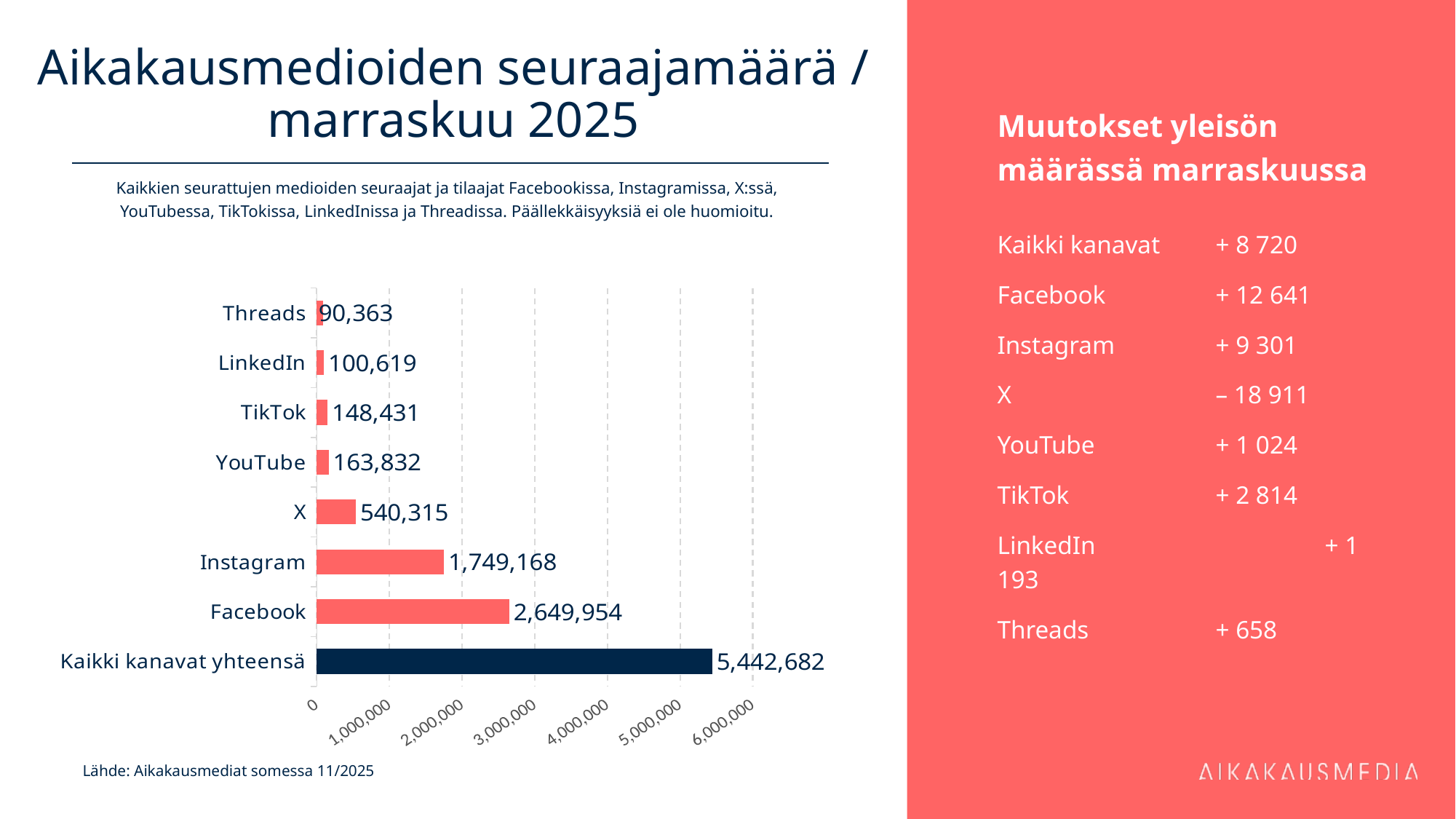
What kind of chart is shown on the slide? Bar chart What is the value for Facebook? 2,649,954 What is the value for Kaikki kanavat yhteensä? 5,442,682 What is the difference between the values for Facebook and Instagram? 900,786 What is the difference between the values for YouTube and TikTok? 15,401 Which is larger, the value for X or the value for YouTube? X What is the value for Instagram? 1,749,168 What is the value for Threads? 90,363 What is the value for X? 540,315 How many bars does the chart show? 8 Which category has the highest value? Kaikki kanavat yhteensä Which category has the lowest value? Threads